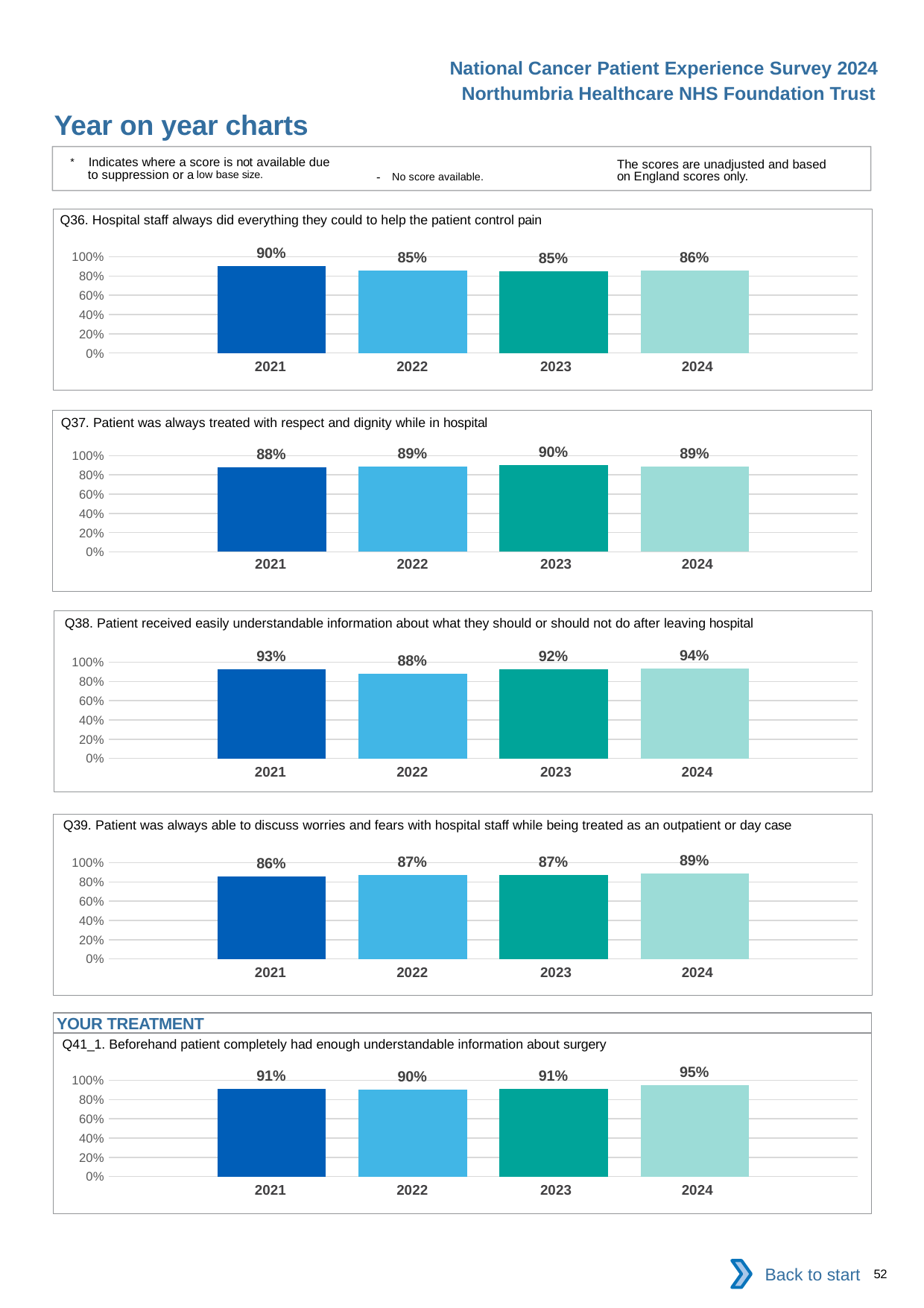
In the Q38 chart (Patient received easily understandable information about what they should or should not do after leaving hospital), which year has the lowest value? 2022 In the Q37 chart, what is the difference between the 2023 value and the 2021 value? 2% What type of chart is the Q41_1 chart? Bar chart In the Q36 chart (Hospital staff always did everything they could to help the patient control pain), what is the value for 2021? 90% In the Q39 chart, what is the difference between the 2024 value and the 2021 value? 3% In the Q39 chart (Patient was always able to discuss worries and fears with hospital staff while being treated as an outpatient or day case), which is larger, the value for 2021 or the value for 2024? 2024 In the Q36 chart, which year has the highest value? 2021 How many years are shown on the x axis of the Q36 chart? 4 In the Q38 chart, what is the value for 2024? 94% In the Q41_1 chart, which year has the highest value? 2024 In the Q41_1 chart (Beforehand patient completely had enough understandable information about surgery), what is the value for 2024? 95% In the Q37 chart (Patient was always treated with respect and dignity while in hospital), what is the value for 2023? 90%